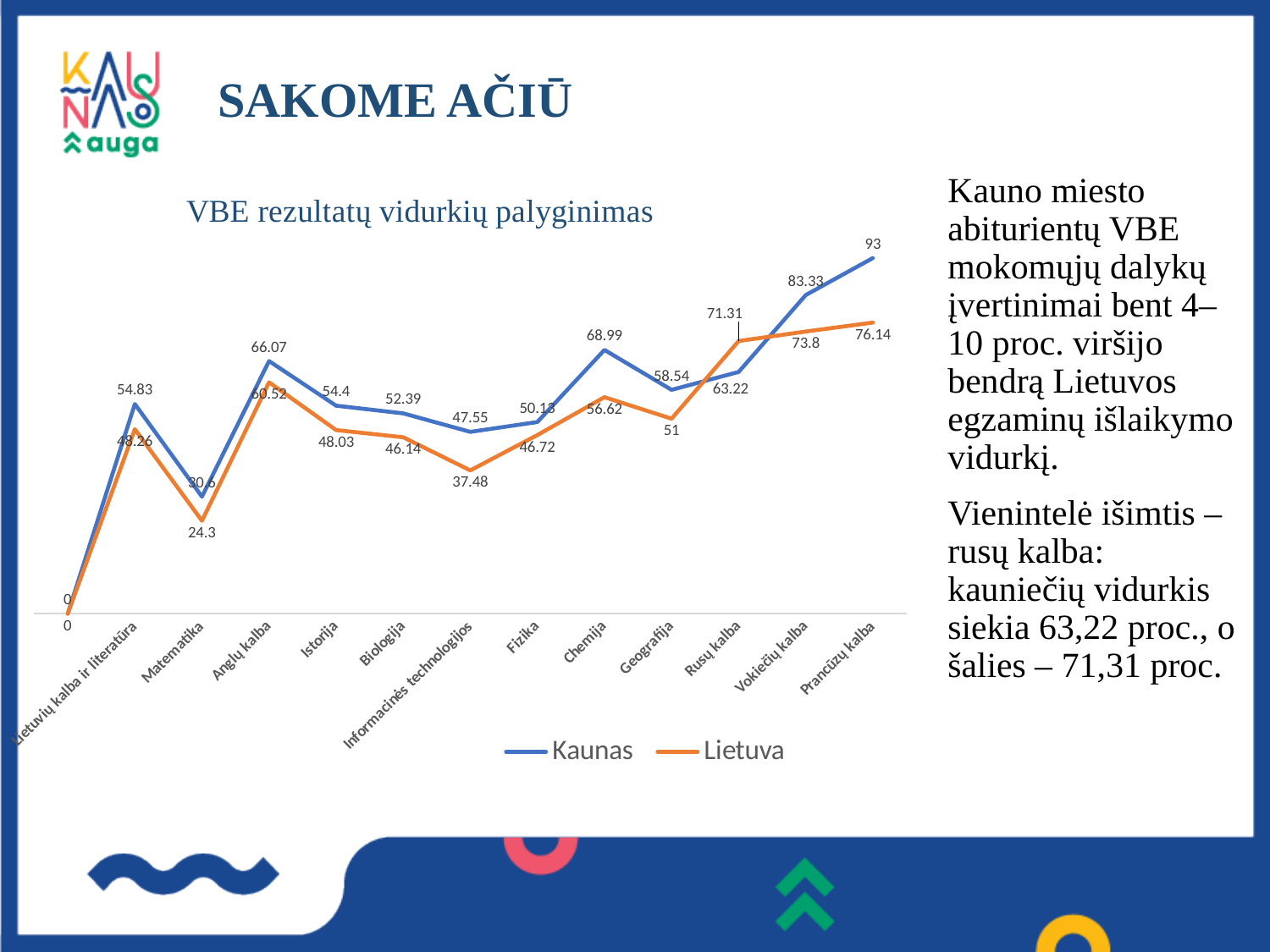
Which subject has the highest Kaunas value? Prancūzų kalba What is the difference between the Kaunas and Lietuva values for Prancūzų kalba? 16.86 What is the title of the chart? VBE rezultatų vidurkių palyginimas What is the Lietuva value for Matematika? 24.3 What is the difference between the Kaunas and Lietuva values for Informacinės technologijos? 10.07 What is the Kaunas value for Chemija? 68.99 What kind of chart is shown on the slide? Line chart What is the Kaunas value for Vokiečių kalba? 83.33 Among the labelled subjects, which has the lowest Lietuva value? Matematika What is the Lietuva value for Geografija? 51 How many series does the legend list? 2 For Rusų kalba, which series has the larger value, Kaunas or Lietuva? Lietuva